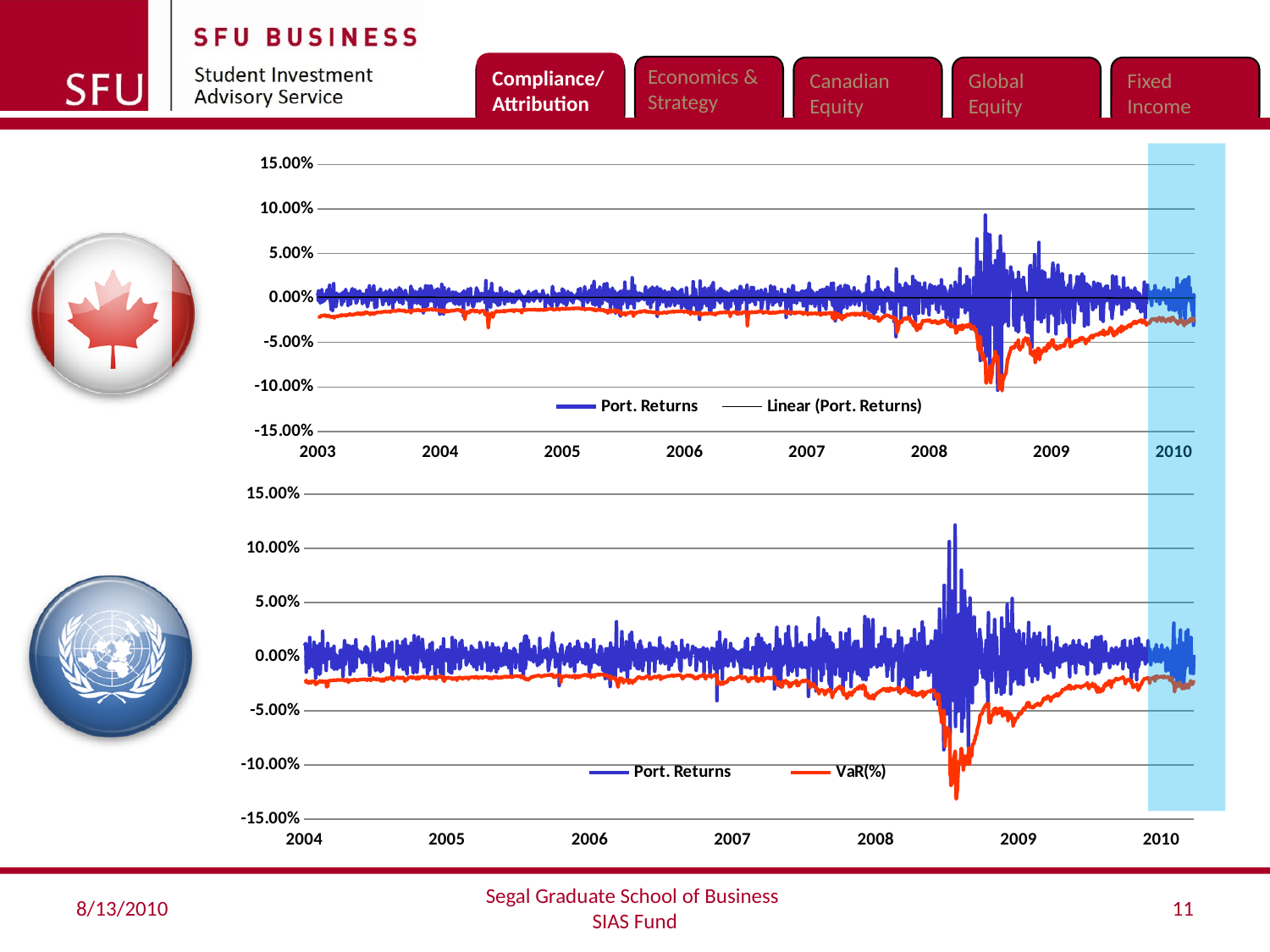
How many year labels are shown on the x axis of the bottom chart? 7 In the bottom chart, what is the name of the red series in the legend? VaR(%) How many series does the legend of the bottom chart list? 2 What is the highest value shown on the y axis of the top chart? 15.00% How many year labels are shown on the x axis of the top chart? 8 What kind of chart is the bottom chart on the slide? line chart In the bottom chart, is the lowest point of Port. Returns greater or less than -10.00%? less How many series does the legend of the top chart list? 2 In the top chart, is the highest peak of Port. Returns greater or less than 5.00%? greater What kind of chart is the top chart on the slide? line chart In the bottom chart, is the highest peak of Port. Returns greater or less than 10.00%? greater In the top chart, what are the two series named in the legend? Port. Returns and Linear (Port. Returns)